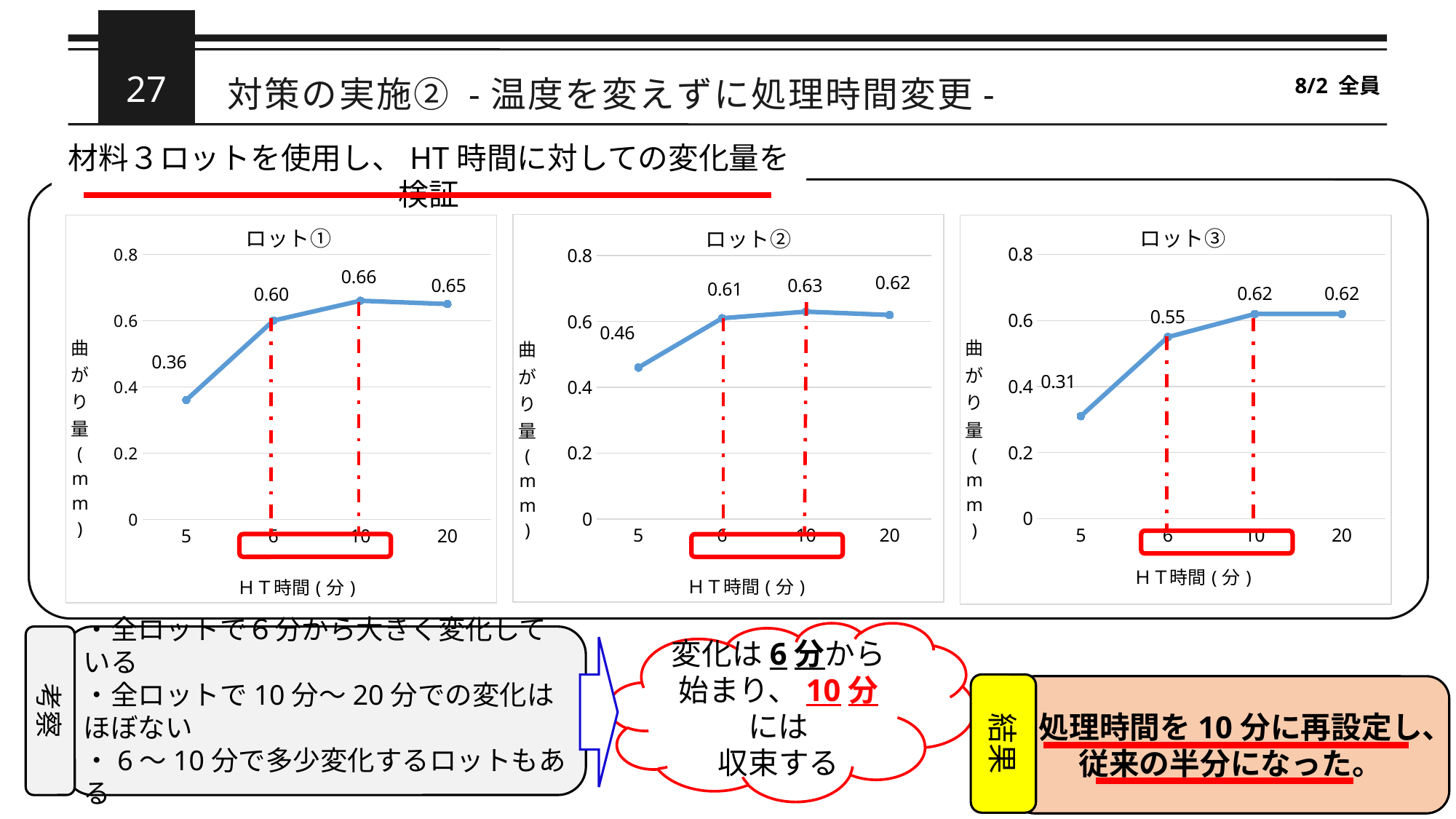
In the ロット① chart, which HT時間 has the highest 曲がり量? 10 In the ロット② chart, is the value at 5 minutes greater or less than 0.4? greater What type of chart is ロット③? Line chart In the ロット② chart, which HT時間 has the lowest 曲がり量? 5 In the ロット② chart, what is the 曲がり量 value at HT時間 10 minutes? 0.63 In the ロット③ chart, what is the difference between the values at 6 minutes and 5 minutes? 0.24 Which is larger: the value at 5 minutes in ロット① or the value at 5 minutes in ロット②? ロット② In the ロット① chart, what is the difference between the values at 10 minutes and 6 minutes? 0.06 In the ロット① chart, what is the 曲がり量 value at HT時間 5 minutes? 0.36 In the ロット③ chart, is the value at 5 minutes greater or less than 0.4? less How many data points are plotted in the ロット① chart? 4 In the ロット③ chart, what is the 曲がり量 value at HT時間 6 minutes? 0.55